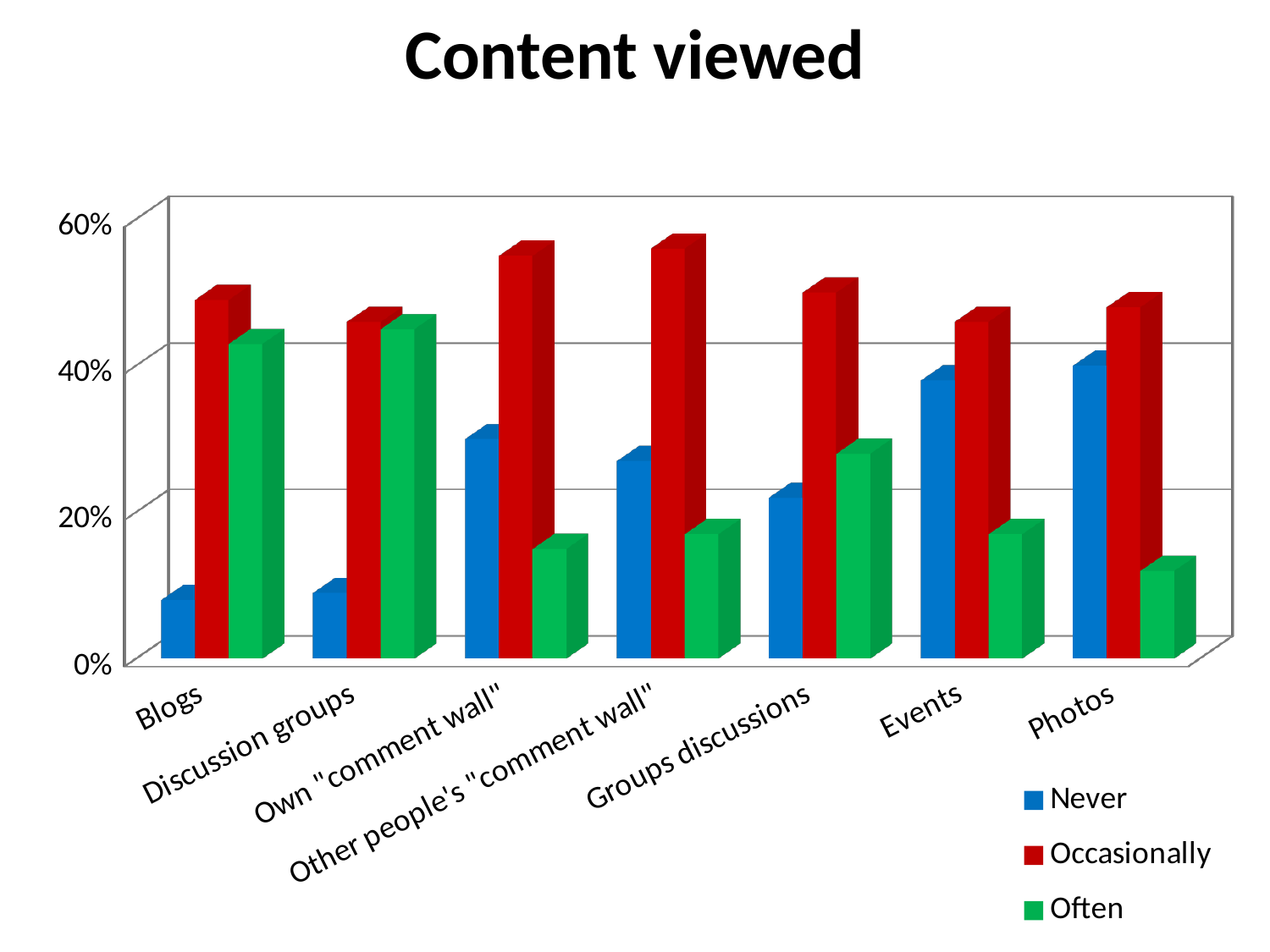
Which is larger: the "Often" value for Blogs or the "Often" value for Photos? Blogs For Blogs, which series has the highest value? Occasionally How many series does the legend list? 3 Is the "Never" value for Blogs greater or less than 20%? less What is the title of the chart? Content viewed For Photos, which series has the lowest value? Often Is the "Often" value for Photos greater or less than 20%? less How many content categories are shown on the x axis? 7 What kind of chart is shown on the slide? bar chart Is the "Occasionally" value for Own "comment wall" greater or less than 40%? greater Which colour represents the "Often" series? green